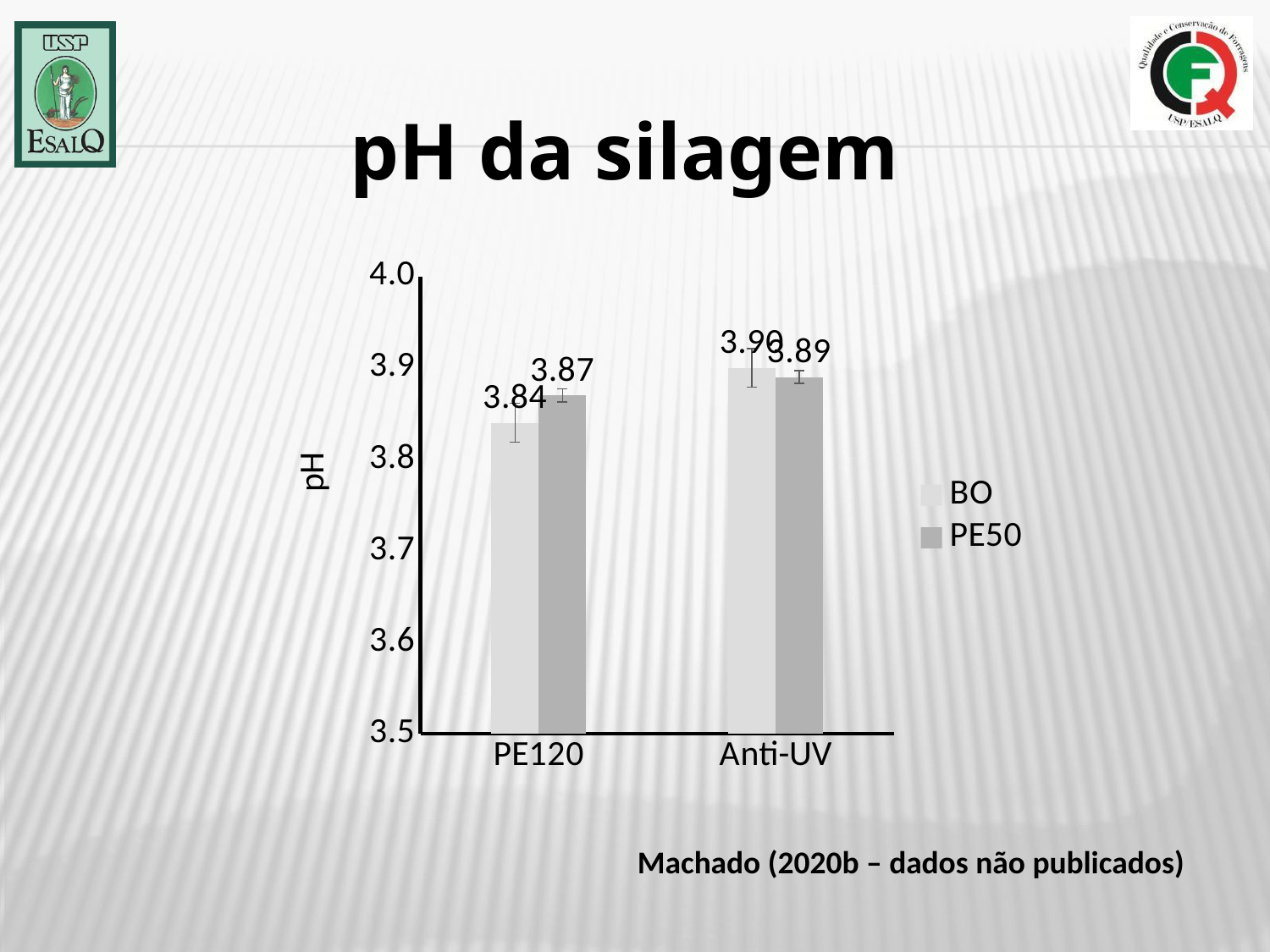
What is the title of the chart on the slide? pH da silagem Which is larger, the BO value under PE120 or the BO value under Anti-UV? BO under Anti-UV What kind of chart is shown on the slide? Bar chart What is the pH value for PE50 under Anti-UV? 3.89 Which bar has the lowest pH value on the chart? BO under PE120 What is the difference between the PE50 and BO pH values under PE120? 0.03 What is the pH value for BO under Anti-UV? 3.90 How many categories are shown on the x axis? 2 What is the pH value for BO under PE120? 3.84 What is the pH value for PE50 under PE120? 3.87 How many series does the legend list? 2 What is the difference between the BO pH values for Anti-UV and PE120? 0.06